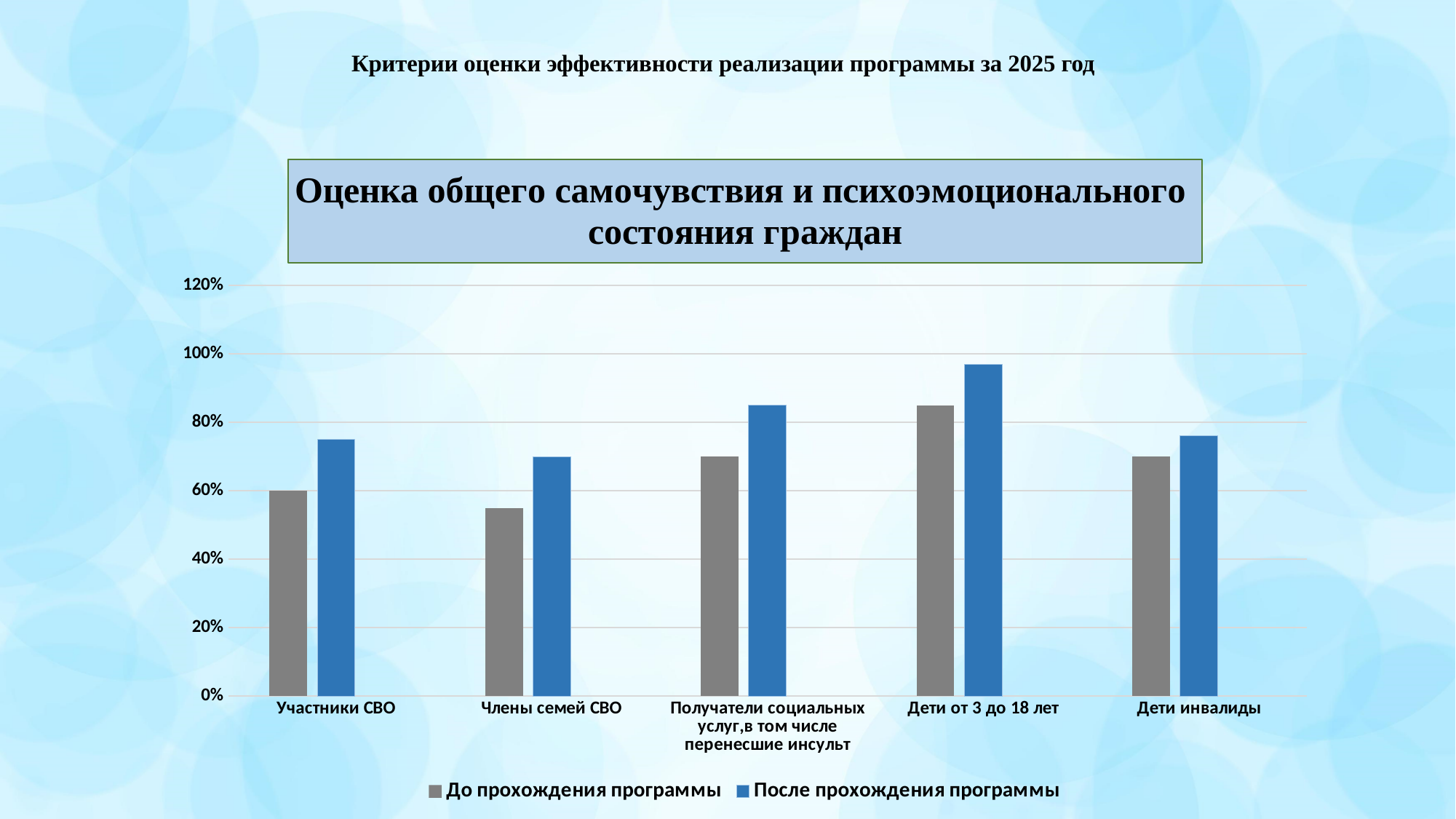
Which category has the lowest value in the series До прохождения программы? Члены семей СВО Which series is shown in blue according to the legend? После прохождения программы What is the title of the chart? Оценка общего самочувствия и психоэмоционального состояния граждан What kind of chart is shown on the slide? bar chart Which category has the highest value in the series После прохождения программы? Дети от 3 до 18 лет What is the value for Участники СВО in the series До прохождения программы? 60% Is the value for Члены семей СВО in the series До прохождения программы greater or less than 60%? less How many series does the legend list? 2 Is the value for Дети от 3 до 18 лет in the series После прохождения программы greater or less than 80%? greater How many categories are shown on the x axis? 5 Is the value for Получатели социальных услуг,в том числе перенесшие инсульт in the series После прохождения программы greater or less than 80%? greater For Дети инвалиды, which series has the larger value: До прохождения программы or После прохождения программы? После прохождения программы